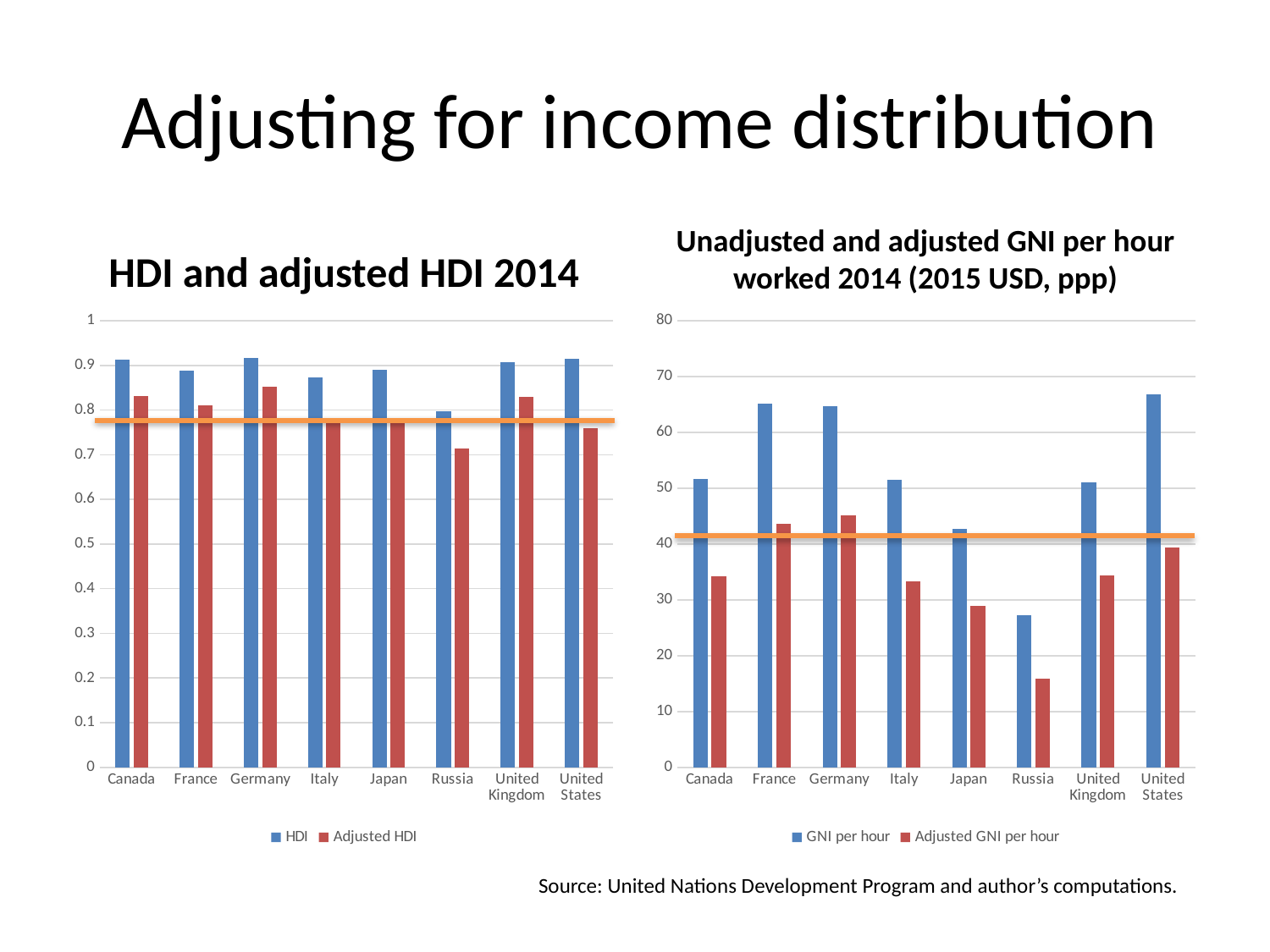
In the 'Unadjusted and adjusted GNI per hour worked 2014' chart, which is larger: the GNI per hour for France or for Japan? France In the 'HDI and adjusted HDI 2014' chart, which country has the lowest Adjusted HDI? Russia In the 'Unadjusted and adjusted GNI per hour worked 2014' chart, what are the two legend entries? GNI per hour; Adjusted GNI per hour In the 'HDI and adjusted HDI 2014' chart, how many series does the legend list? 2 In the 'Unadjusted and adjusted GNI per hour worked 2014' chart, is the Adjusted GNI per hour for Canada greater or less than 40? less In the 'HDI and adjusted HDI 2014' chart, what kind of chart is used? Bar chart In the 'HDI and adjusted HDI 2014' chart, is the Adjusted HDI for Russia greater or less than 0.8? less In the 'HDI and adjusted HDI 2014' chart, is the Adjusted HDI for Germany greater or less than 0.8? greater In the 'Unadjusted and adjusted GNI per hour worked 2014' chart, which country has the lowest GNI per hour? Russia In the 'HDI and adjusted HDI 2014' chart, which country has the lowest HDI? Russia In the 'HDI and adjusted HDI 2014' chart, how many countries are shown on the x axis? 8